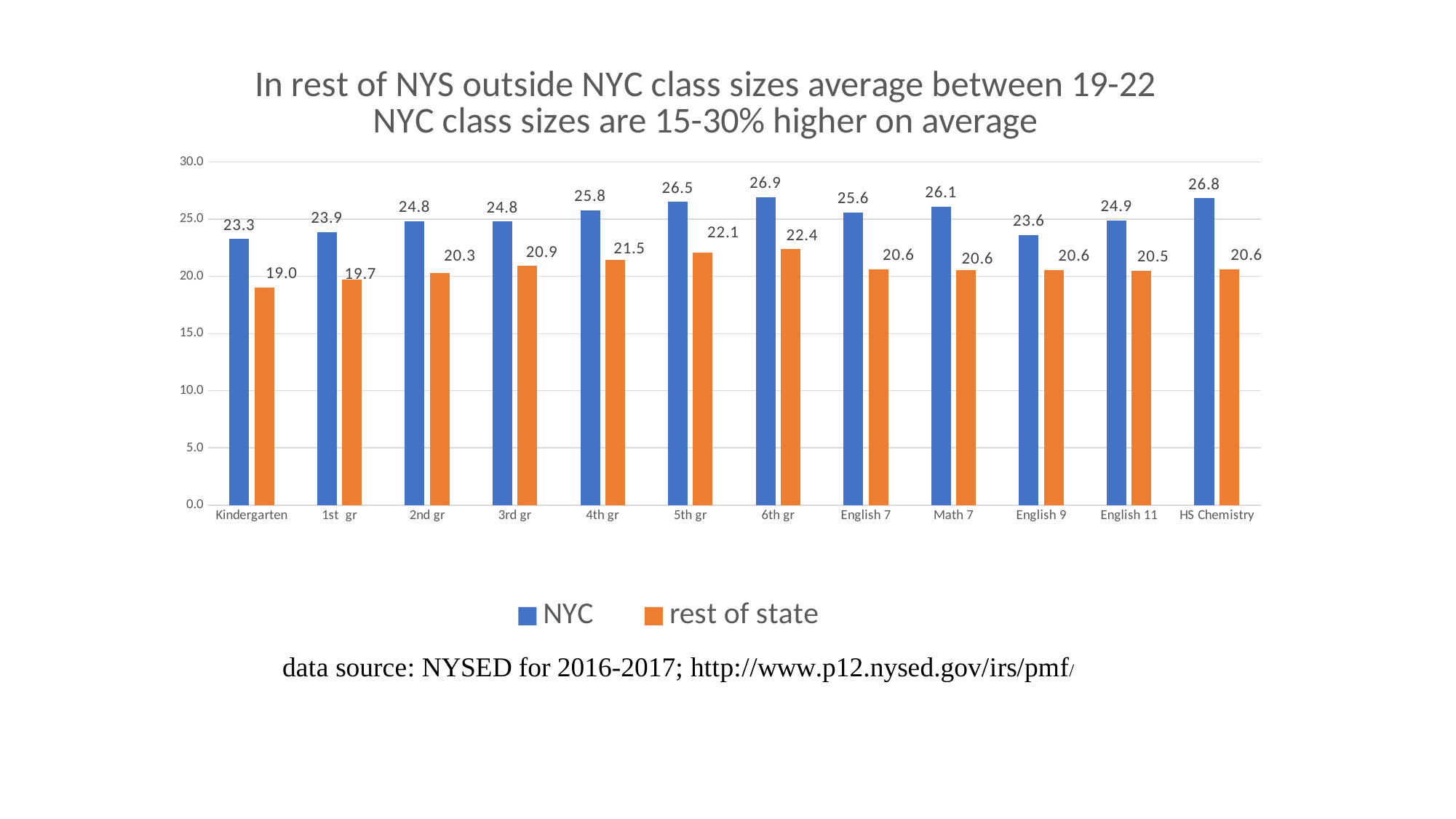
What kind of chart is shown on the slide? bar chart How many categories are shown on the x axis? 12 What is the difference between the NYC and rest of state values for HS Chemistry? 6.2 Which category has the highest NYC class size? 6th gr What is the rest of state value for 5th gr? 22.1 Which colour represents the rest of state series? orange What is the rest of state average class size for Kindergarten? 19.0 Is the rest of state value for 3rd gr greater or less than 25.0? less How many series does the legend list? 2 Which is larger, the NYC value for 4th gr or the NYC value for English 9? 4th gr Which category has the lowest rest of state class size? Kindergarten What is the NYC average class size for 6th gr? 26.9